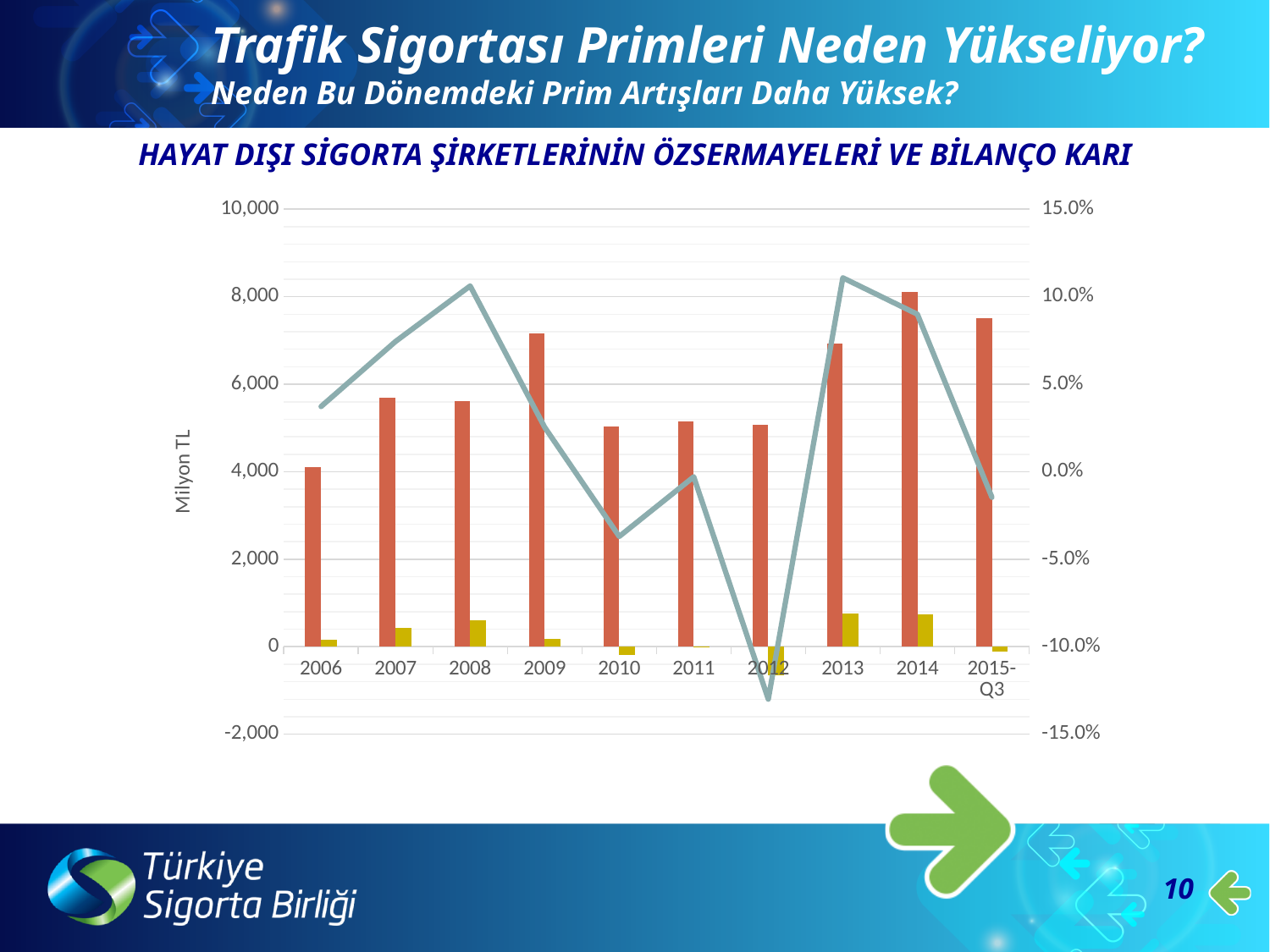
In which year is the red bar the highest? 2014 In which year is the red bar the lowest? 2006 How many categories (years) are shown on the x axis of the chart? 10 In which year does the line reach its lowest point? 2012 Is the red bar for 2010 greater or less than 6,000? less What is the label of the left vertical axis of the chart? Milyon TL Is the line value for 2012 greater or less than -10.0%? less What kind of chart is shown on the slide? Combined bar and line chart Is the line value for 2008 greater or less than 5.0%? greater What is the title of the chart on the slide? HAYAT DIŞI SİGORTA ŞİRKETLERİNİN ÖZSERMAYELERİ VE BİLANÇO KARI Which year has the larger red bar, 2009 or 2010? 2009